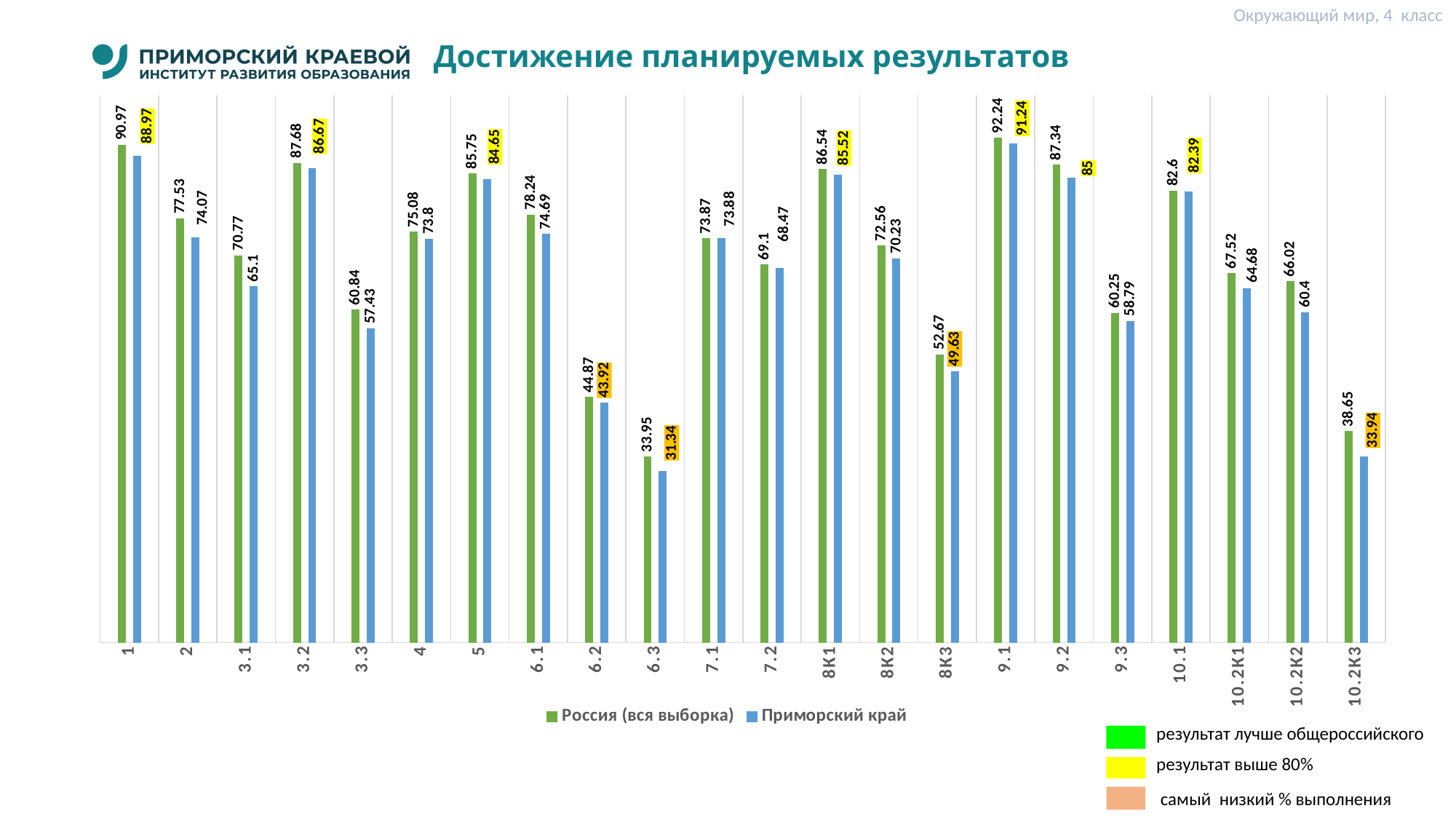
What type of chart is shown on the slide? bar chart How many categories are shown on the x axis of the chart? 22 Which category has the highest value for Приморский край? 9.1 Which category has the lowest value for Россия (вся выборка)? 6.3 What is the value for Приморский край in category 9.2? 85 Which is larger: the Приморский край value for 10.2К2 or for 10.2К1? 10.2К1 What is the value for Приморский край in category 1? 88.97 Which is larger in category 7.1: the value for Россия (вся выборка) or for Приморский край? Приморский край Which colour represents the series Приморский край in the chart? blue How many series does the chart legend list? 2 What is the difference between the Россия (вся выборка) and Приморский край values in category 3.1? 5.67 What is the value for Россия (вся выборка) in category 8К3? 52.67